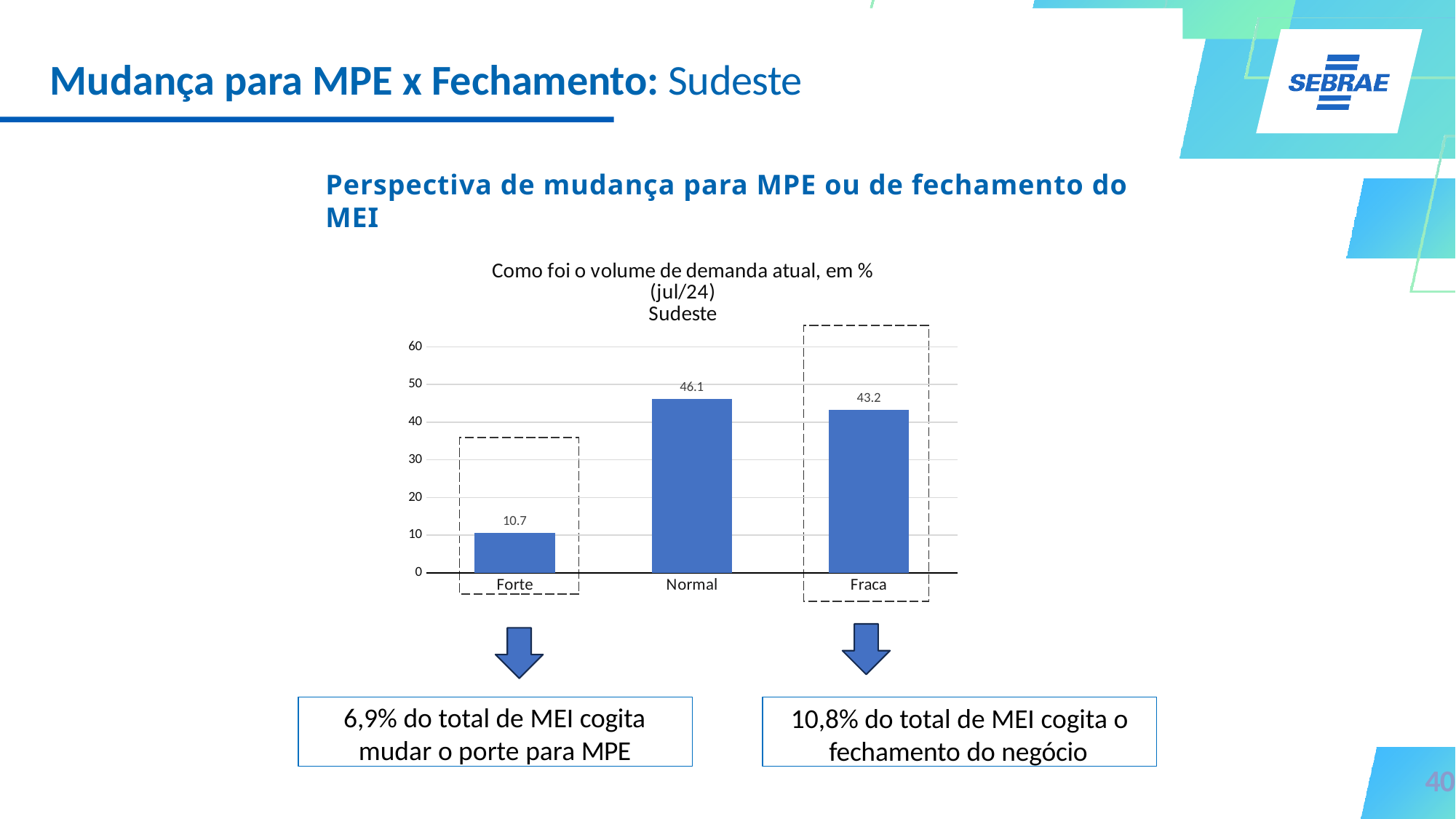
What is the value for Normal? 46.1 What is the difference between the values for Normal and Fraca? 2.9 Which category has the lowest value? Forte Is the value for Normal greater or less than 40? greater What is the difference between the values for Fraca and Forte? 32.5 What kind of chart is shown on the slide? bar chart What is the value for Fraca? 43.2 What is the title of the chart? Como foi o volume de demanda atual, em % (jul/24) Sudeste What is the value for Forte? 10.7 Which category has the highest value? Normal Which is larger, the value for Forte or the value for Fraca? Fraca How many categories are shown on the x axis? 3